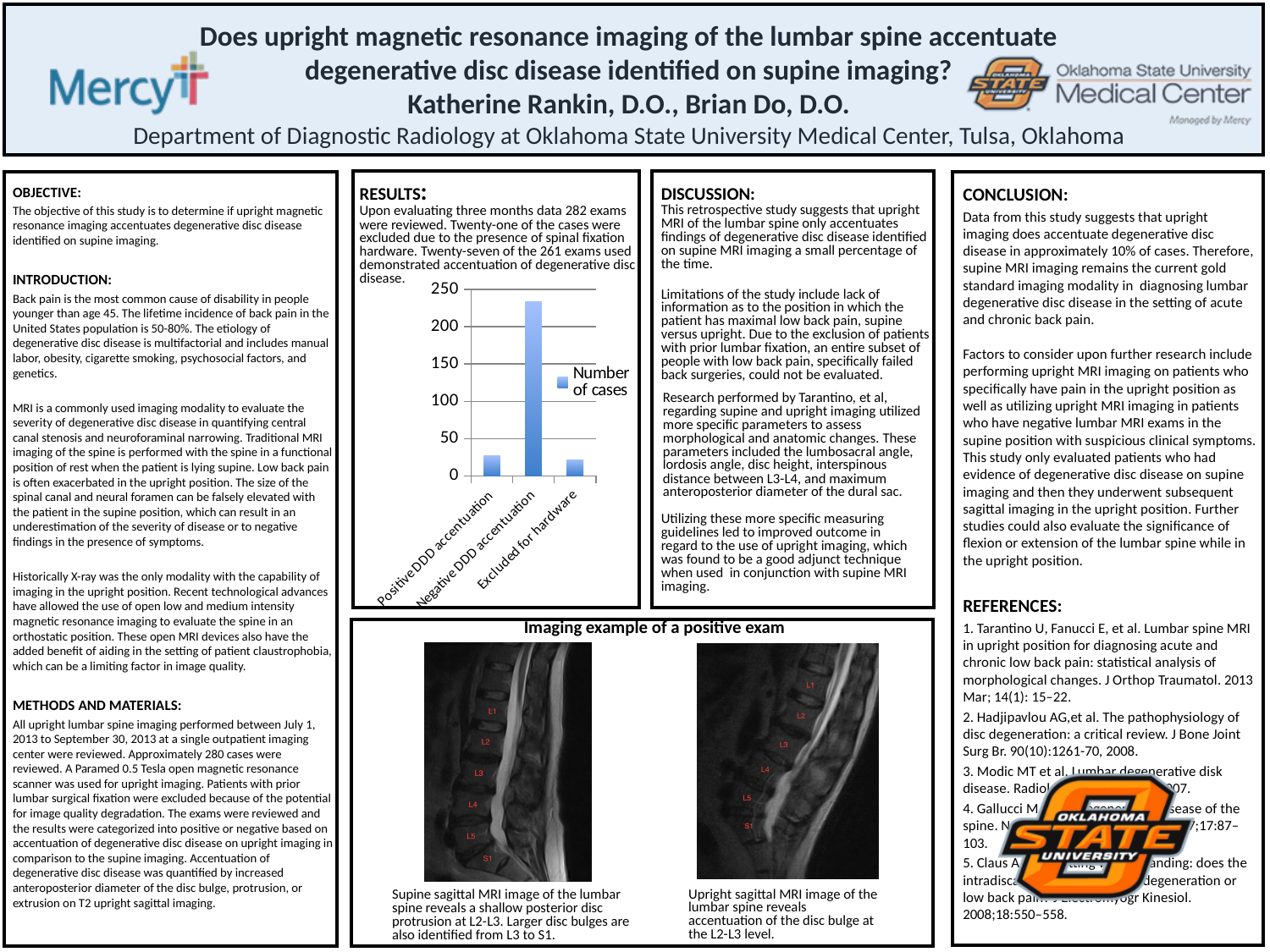
What is the highest tick value shown on the y axis of the bar chart? 250 How many categories are shown on the x axis of the bar chart? 3 Is the value for Positive DDD accentuation greater or less than 50? less Which category has the highest number of cases in the bar chart? Negative DDD accentuation How many series does the legend of the bar chart list? 1 Is the value for Negative DDD accentuation greater or less than 200? greater What kind of chart is shown in the Results section? bar chart Which is larger in the bar chart: Negative DDD accentuation or Positive DDD accentuation? Negative DDD accentuation Is the value for Excluded for hardware greater or less than 50? less What is the legend entry of the bar chart? Number of cases Which is larger in the bar chart: Negative DDD accentuation or Excluded for hardware? Negative DDD accentuation